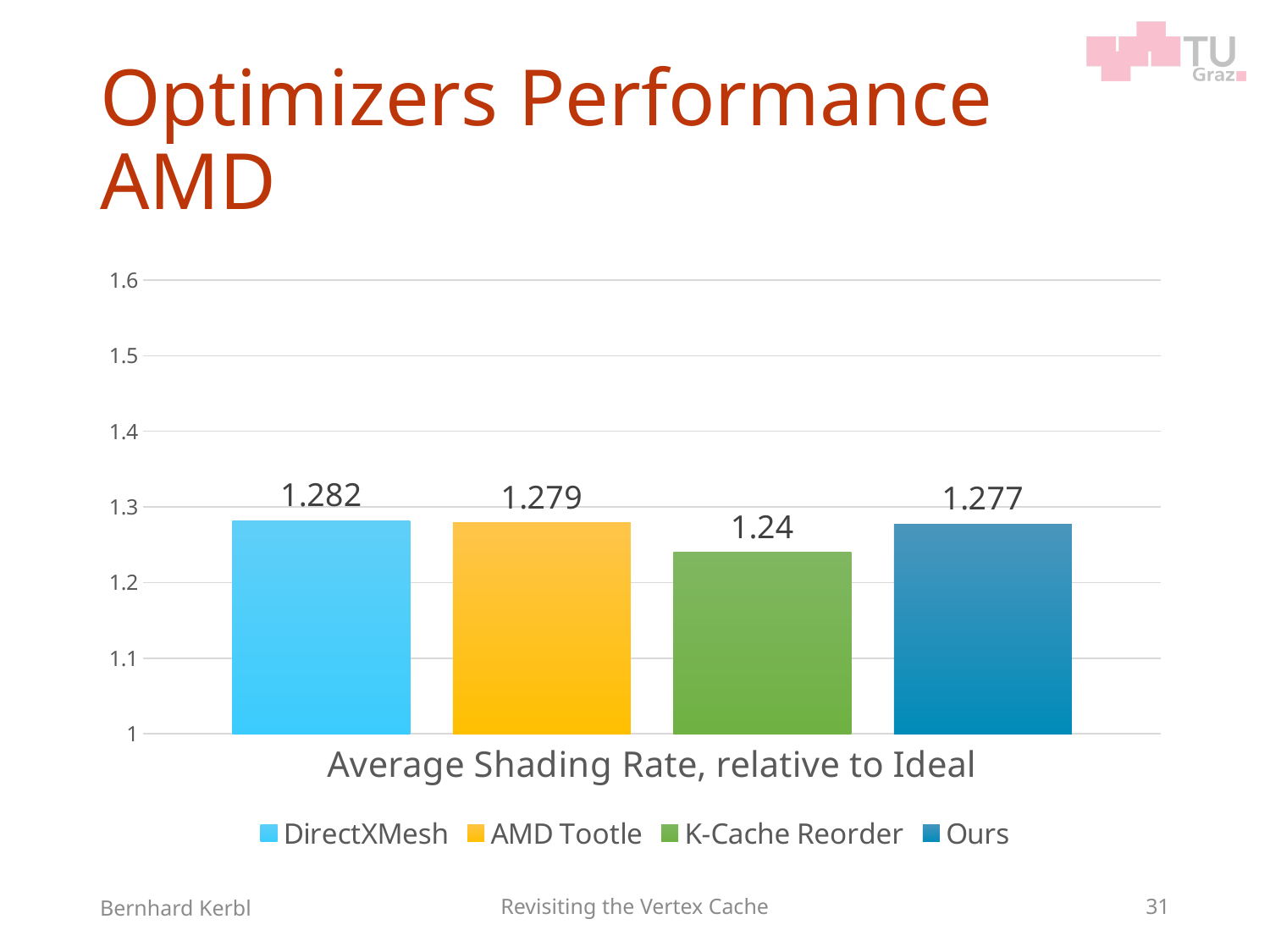
Which series has the highest value in the chart? DirectXMesh What is the value shown for AMD Tootle? 1.279 What is the value shown for Ours? 1.277 How many series does the legend list? 4 What is the difference between the values for AMD Tootle and Ours? 0.002 What is the Average Shading Rate, relative to Ideal for DirectXMesh? 1.282 What kind of chart is shown on the slide? Bar chart What is the difference between the values for DirectXMesh and K-Cache Reorder? 0.042 What is the value shown for K-Cache Reorder? 1.24 Is the value for K-Cache Reorder greater or less than 1.3? less Which series has the lowest Average Shading Rate, relative to Ideal? K-Cache Reorder What colour is the bar for K-Cache Reorder? Green